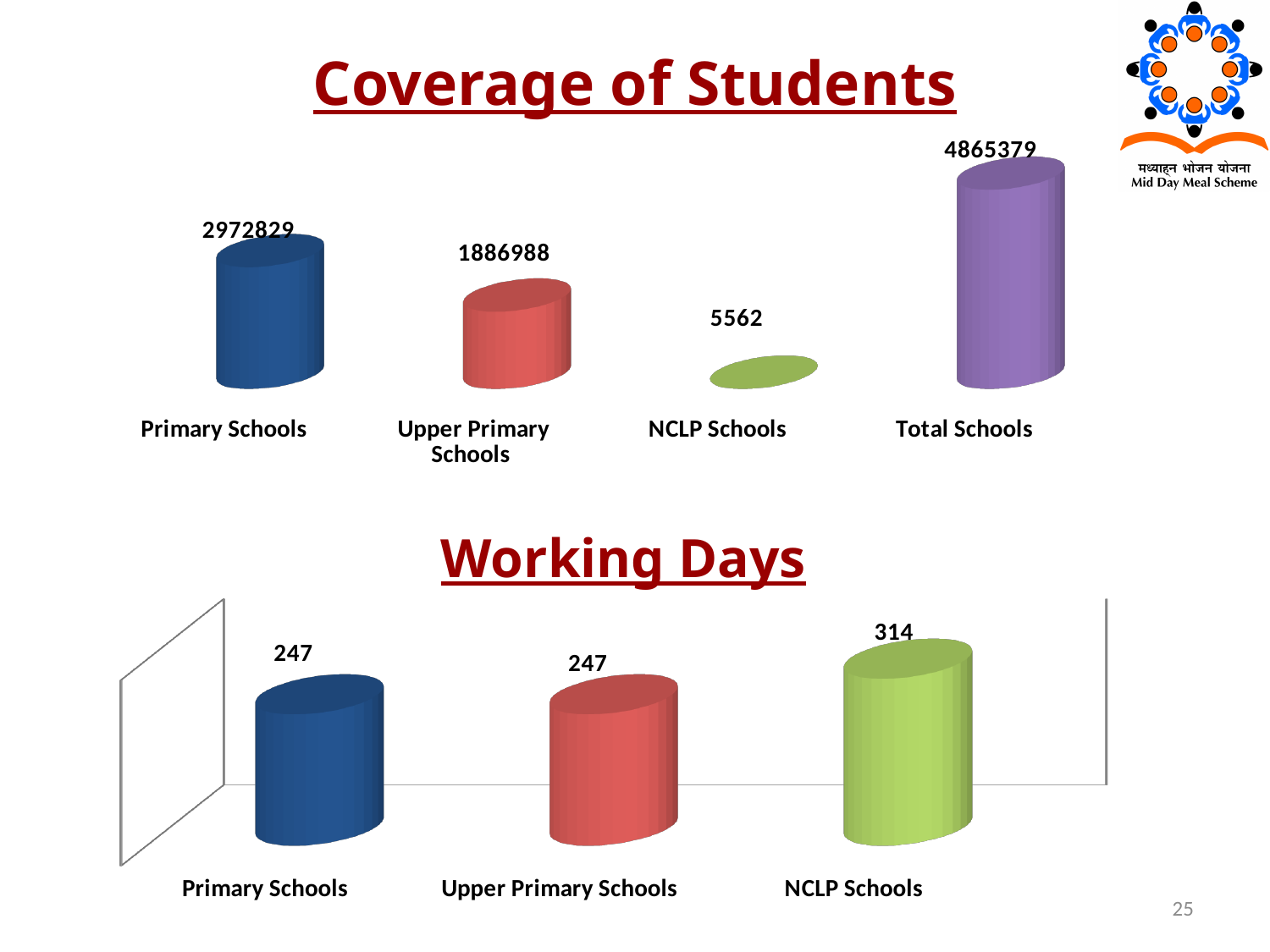
In the Working Days chart, which category has the highest value? NCLP Schools In the Coverage of Students chart, what is the value for Upper Primary Schools? 1886988 In the Coverage of Students chart, what is the value for NCLP Schools? 5562 In the Coverage of Students chart, how many categories are shown? 4 In the Coverage of Students chart, what is the value for Primary Schools? 2972829 In the Coverage of Students chart, which category has the highest value? Total Schools What kind of chart is the Working Days chart? Bar chart In the Coverage of Students chart, what is the difference between Primary Schools and Upper Primary Schools? 1085841 In the Working Days chart, what is the value for Upper Primary Schools? 247 In the Working Days chart, what is the difference between NCLP Schools and Primary Schools? 67 In the Coverage of Students chart, which category has the lowest value? NCLP Schools In the Working Days chart, what is the value for NCLP Schools? 314